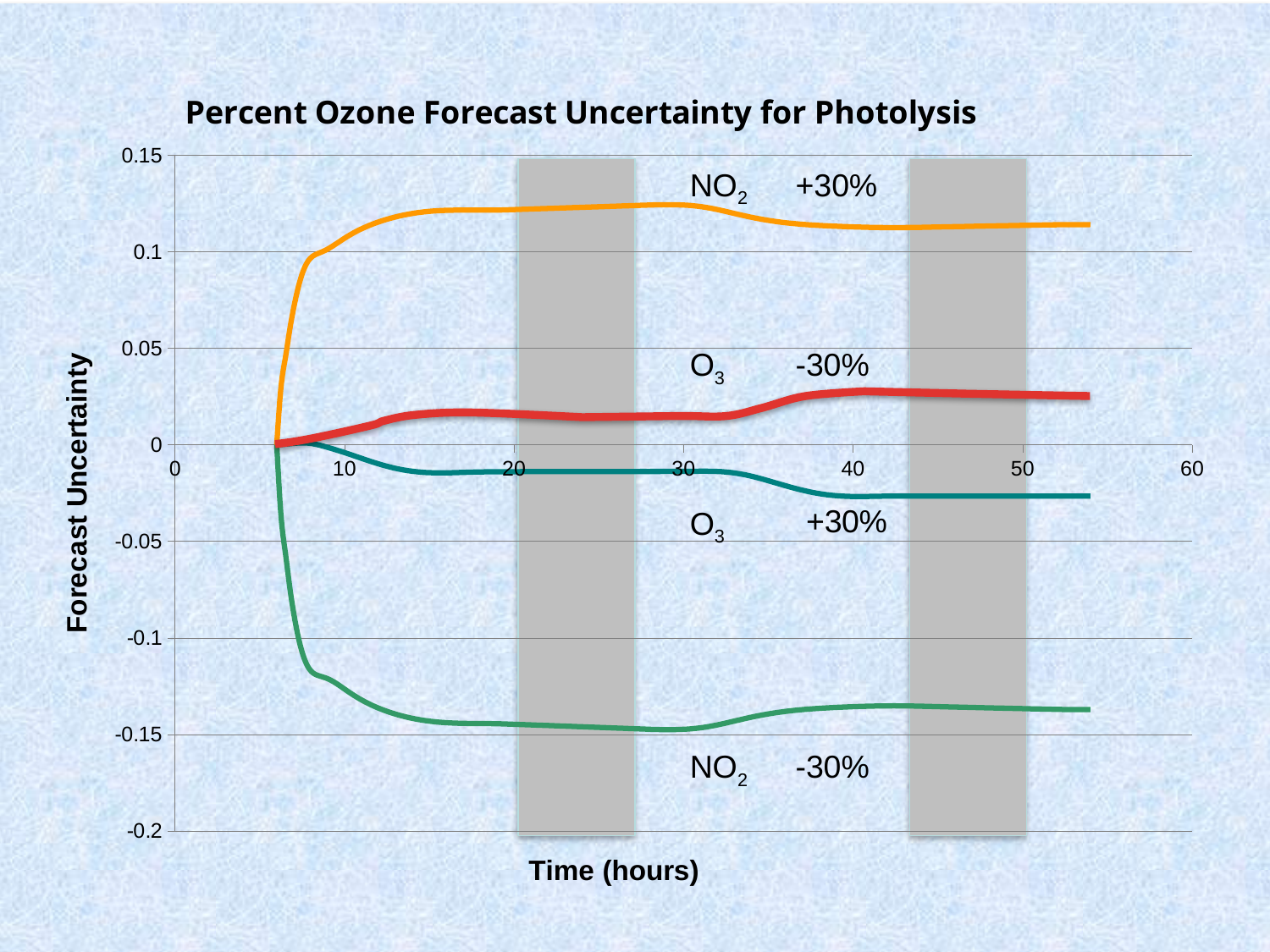
What kind of chart is shown on the slide? Line chart Is the value of the NO2 -30% line at 30 hours greater or less than -0.1? less At 40 hours, which line has the higher value, NO2 +30% or O3 -30%? NO2 +30% Does the NO2 +30% line rise or fall between 30 and 40 hours? fall What is the label of the x axis? Time (hours) Which line reaches the highest forecast uncertainty on the chart? NO2 +30% Is the value of the O3 -30% line at 40 hours greater or less than 0.05? less What is the title of the chart? Percent Ozone Forecast Uncertainty for Photolysis Is the value of the NO2 +30% line at 20 hours greater or less than 0.1? greater Which line reaches the lowest forecast uncertainty on the chart? NO2 -30% How many lines are plotted on the chart? 4